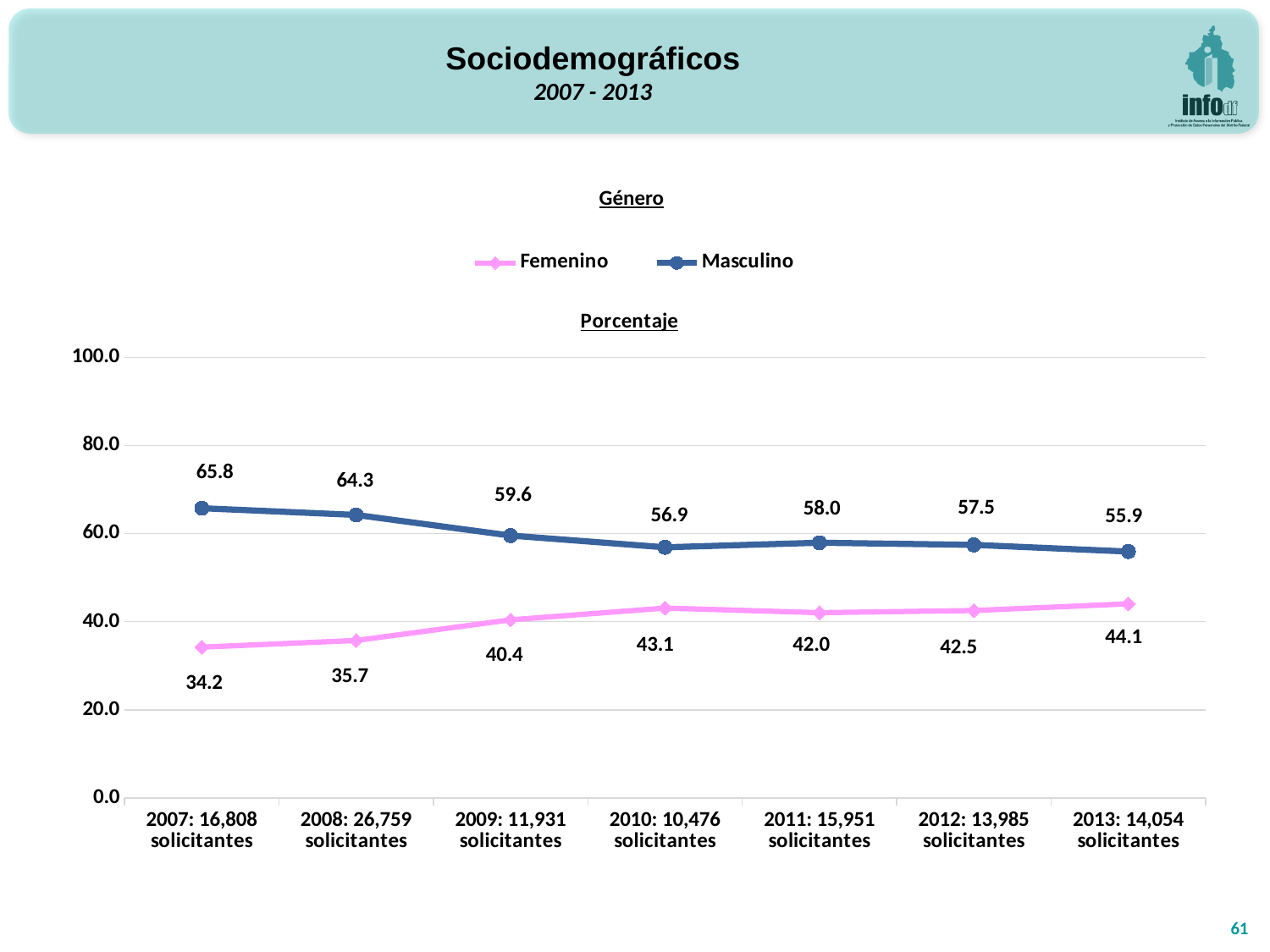
What kind of chart is shown? line chart Which is larger in 2012, the Masculino value or the Femenino value? Masculino In which year is the Masculino value lowest? 2013 What is the difference between the Masculino and Femenino values in 2007? 31.6 What is the Femenino value for 2010? 43.1 In which year is the Femenino value highest? 2013 How many years are shown on the x axis? 7 What is the Femenino value for 2013? 44.1 How many series does the legend list? 2 Is the Femenino value for 2009 greater or less than 60.0? less What is the Masculino value for 2007? 65.8 Does the Masculino series generally rise or fall from 2007 to 2013? fall